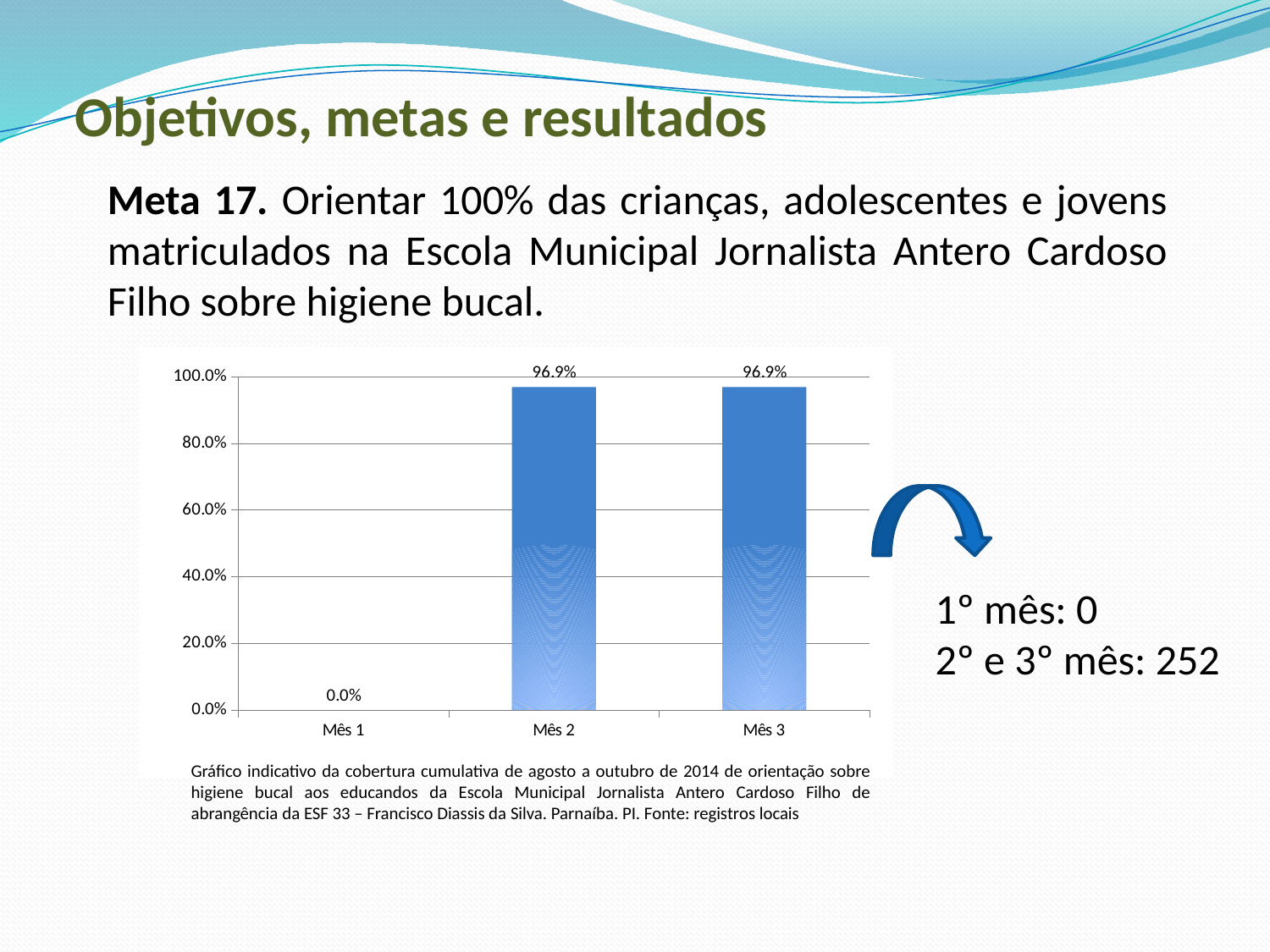
Do the values rise or fall from Mês 1 to Mês 2? rise Are the values for Mês 2 and Mês 3 equal? yes Which is larger, the value for Mês 1 or the value for Mês 3? Mês 3 Is the value for Mês 2 greater or less than 80.0%? greater How many categories are shown on the x axis? 3 What is the highest value shown on the y axis? 100.0% Which category has the lowest value? Mês 1 What is the value for Mês 2? 96.9% What is the value for Mês 1? 0.0% What is the value for Mês 3? 96.9% What kind of chart is shown on the slide? bar chart What is the difference between the values for Mês 2 and Mês 1? 96.9%